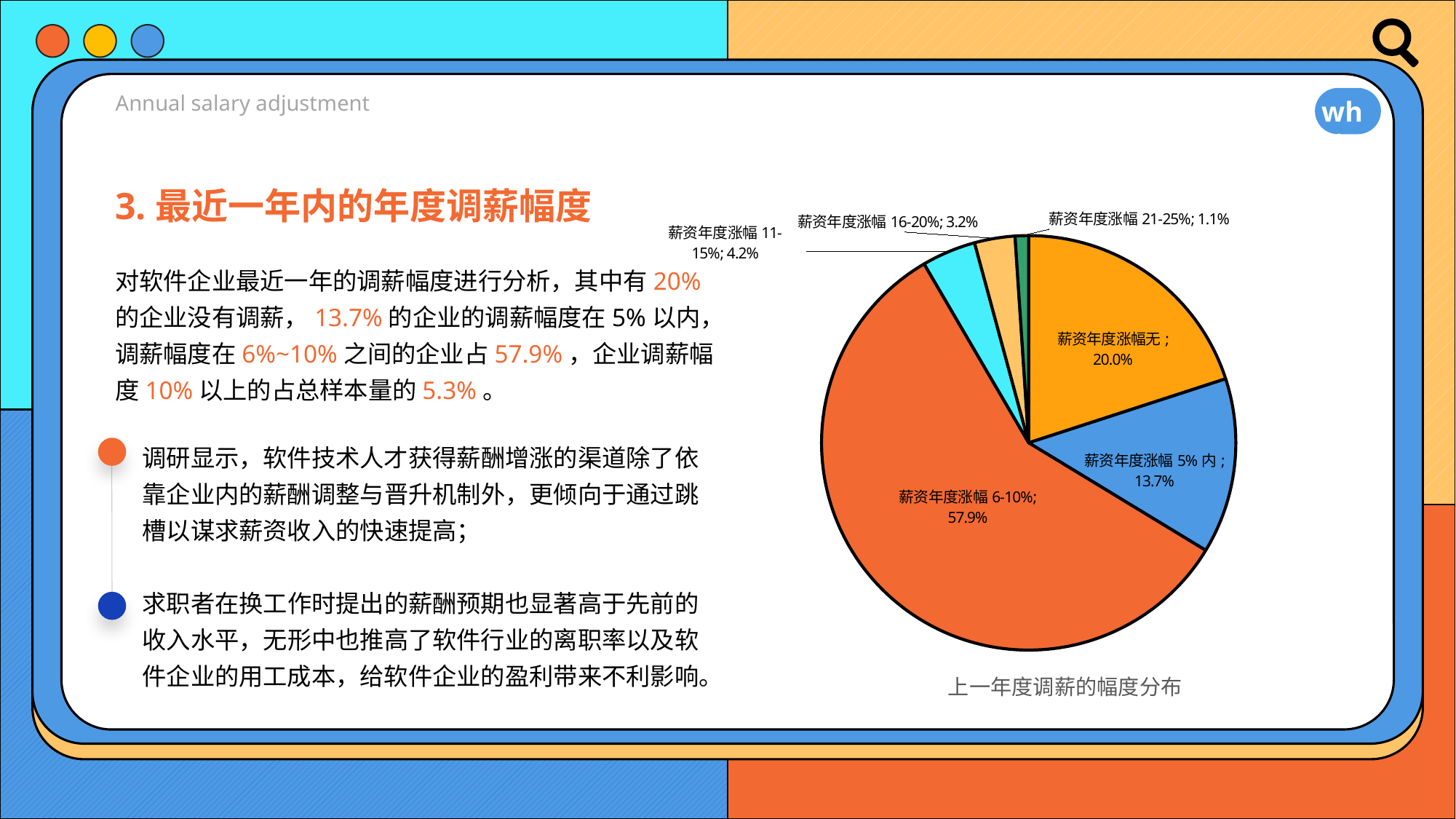
What is the value for 薪资年度涨幅无? 20.0% Which category has the largest share of the pie? 薪资年度涨幅 6-10% What is the value for 薪资年度涨幅 11-15%? 4.2% Which is larger, the value for 薪资年度涨幅 11-15% or 薪资年度涨幅 16-20%? 薪资年度涨幅 11-15% What is the value for 薪资年度涨幅 6-10%? 57.9% What is the value for 薪资年度涨幅 21-25%? 1.1% What type of chart is shown on the slide? Pie chart How many slices does the pie chart have? 6 What is the title of the chart? 上一年度调薪的幅度分布 What is the difference between the values for 薪资年度涨幅无 and 薪资年度涨幅 5% 内? 6.3% What is the value for 薪资年度涨幅 5% 内? 13.7% Which category has the smallest share of the pie? 薪资年度涨幅 21-25%